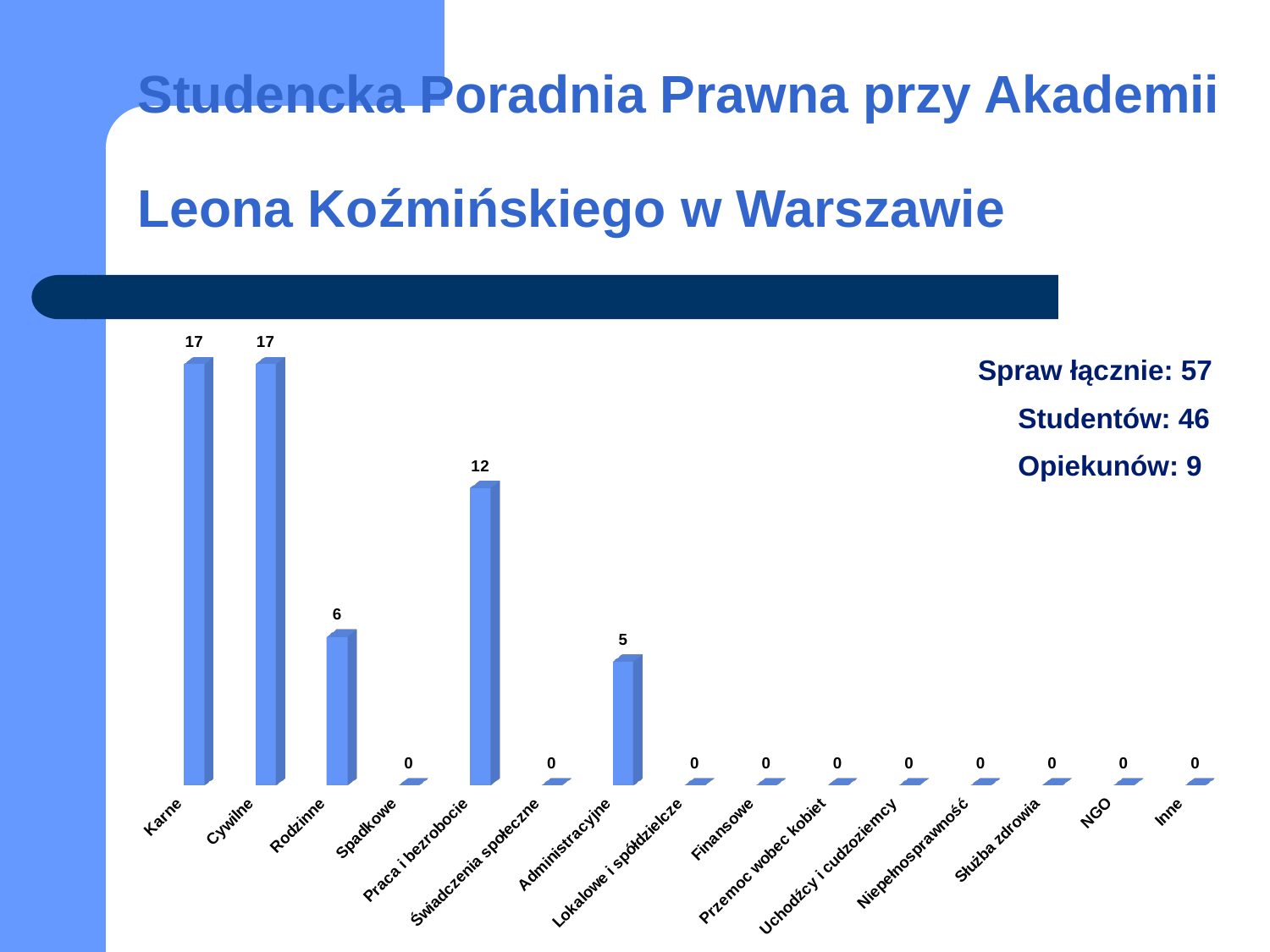
What is the highest value shown on the chart? 17 What is the value for Praca i bezrobocie? 12 What is the value for Karne? 17 What kind of chart is shown on the slide? bar chart What is the value for Spadkowe? 0 What is the difference between the values for Rodzinne and Administracyjne? 1 How many categories are shown on the x axis? 15 What is the difference between the values for Cywilne and Praca i bezrobocie? 5 What is the value for Rodzinne? 6 What is the value for Administracyjne? 5 Which is larger, the value for Praca i bezrobocie or the value for Rodzinne? Praca i bezrobocie How many categories have a value of 0? 10